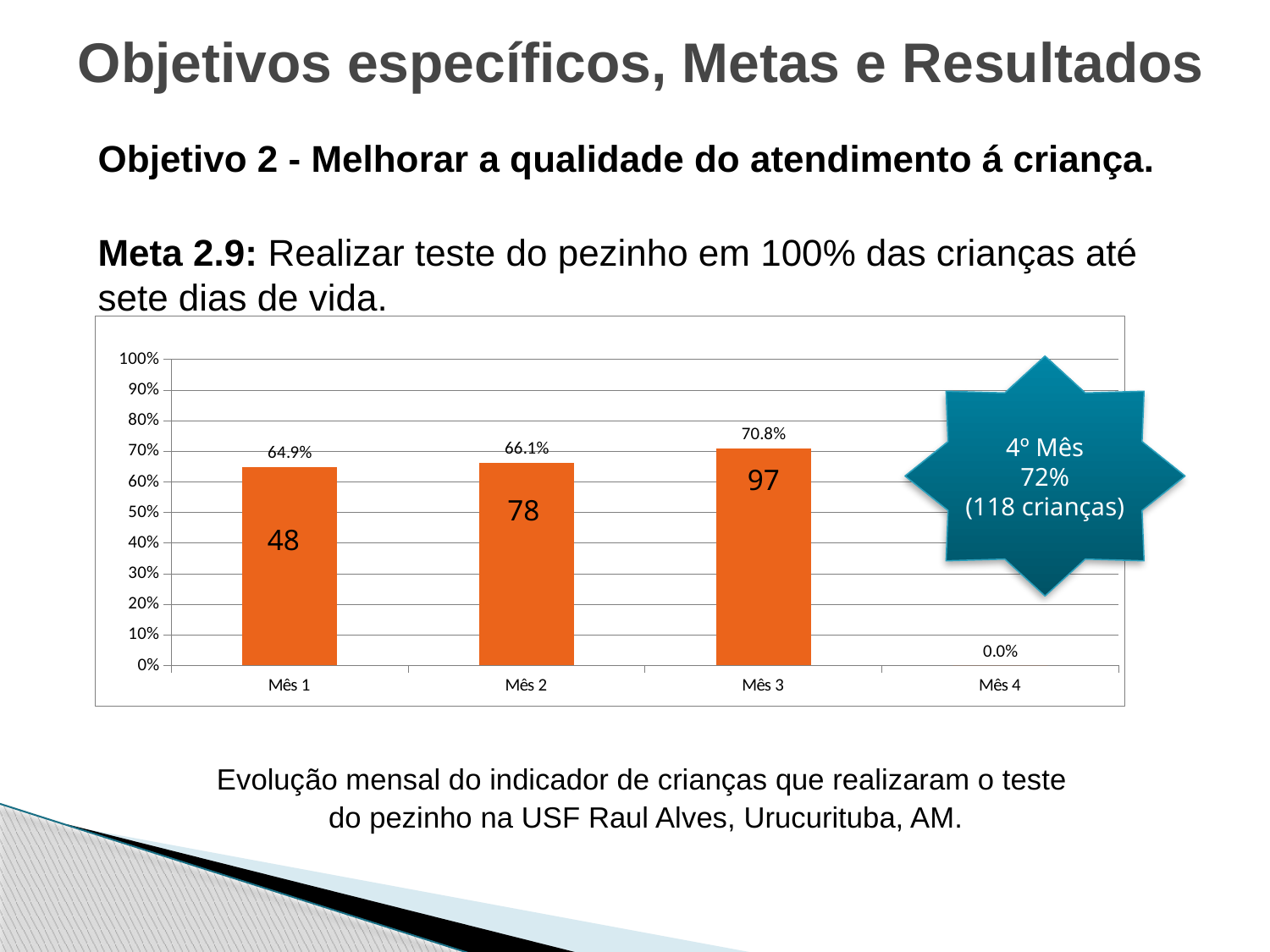
Do the values rise or fall from Mês 1 to Mês 3? Rise What number is printed inside the bar for Mês 1? 48 What is the value for Mês 3? 70.8% How many months are shown on the x axis? 4 Which is larger, the value for Mês 2 or the value for Mês 1? Mês 2 What is the value for Mês 2? 66.1% What is the value for Mês 1? 64.9% What value is printed for Mês 4 on the chart? 0.0% What is the difference in percentage points between Mês 3 and Mês 1? 5.9 Which month has the highest percentage bar? Mês 3 What kind of chart is shown? Bar chart What number is printed inside the bar for Mês 3? 97